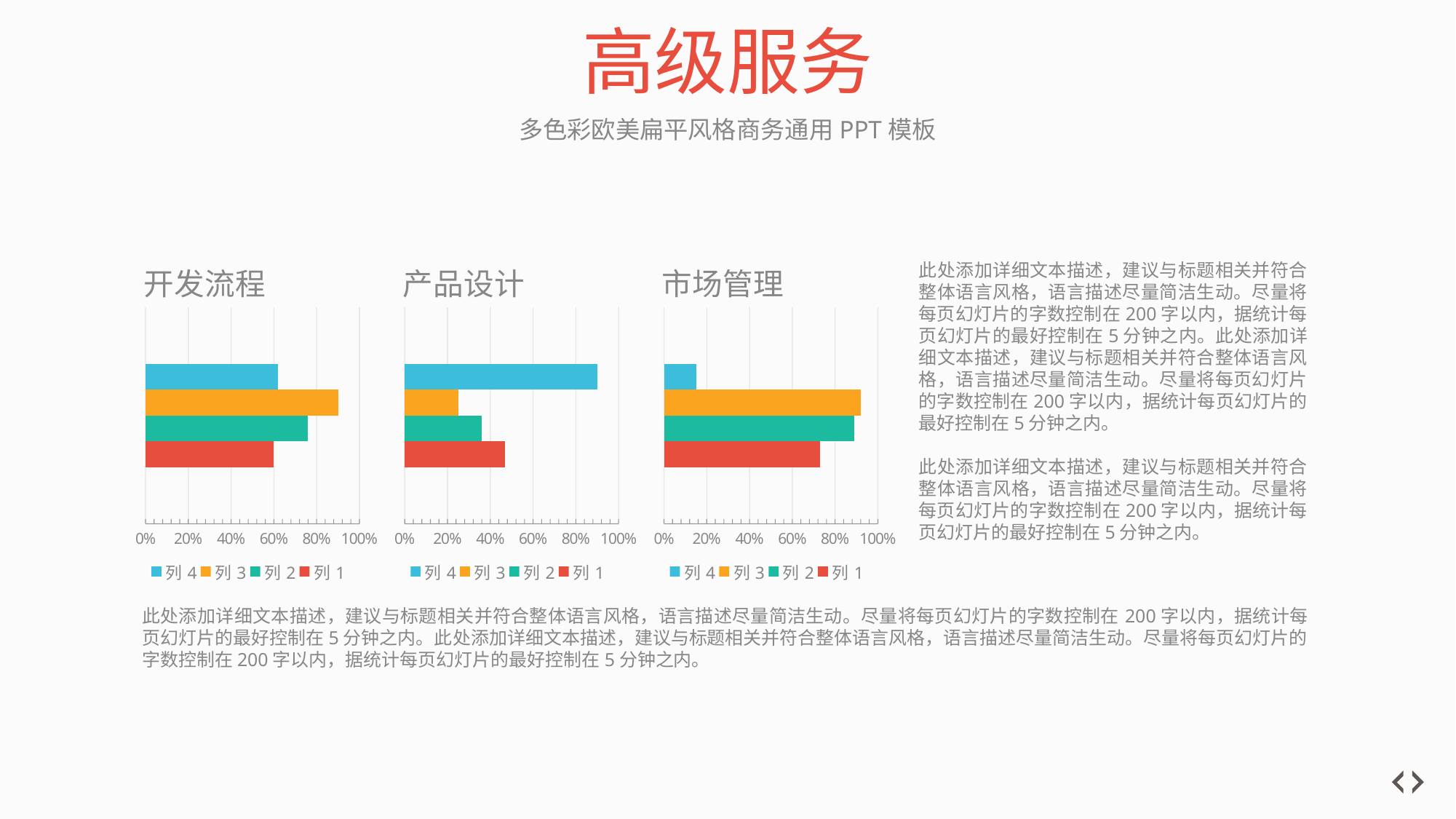
In the 产品设计 chart, which series has the highest value? 列 4 In the 市场管理 chart, which series has the lowest value? 列 4 In the 市场管理 chart, is the value for 列 4 greater or less than 20%? less In the 市场管理 chart, which is larger, 列 1 or 列 4? 列 1 What colour represents 列 1 in the legends of the charts? red In the 产品设计 chart, which series has the lowest value? 列 3 In the 开发流程 chart, is the value for 列 3 greater or less than 80%? greater How many series does the legend of the 产品设计 chart list? 4 In the 产品设计 chart, is the value for 列 1 greater or less than 60%? less In the 产品设计 chart, which is larger, 列 2 or 列 1? 列 1 What kind of chart is the 开发流程 chart? bar chart In the 开发流程 chart, which series has the highest value? 列 3